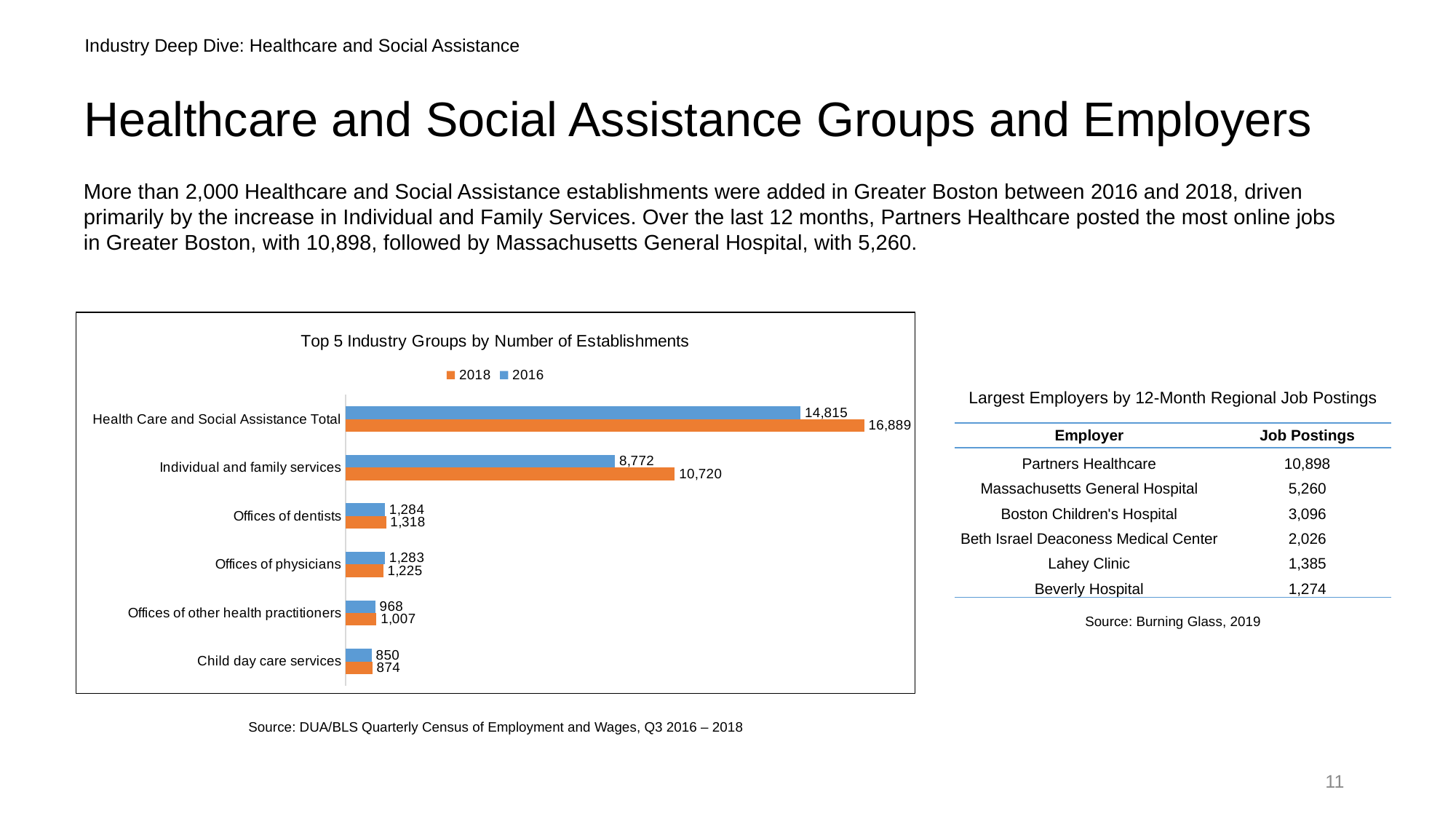
How many series does the chart legend list? 2 What type of chart is used to show the Top 5 Industry Groups by Number of Establishments? Bar chart What was the Health Care and Social Assistance Total in 2016? 14,815 For Offices of physicians, which year had more establishments, 2016 or 2018? 2016 What was the number of establishments for Individual and family services in 2018? 10,720 Excluding the total, which industry group had the most establishments in 2018? Individual and family services How many categories are shown on the chart? 6 What was the number of establishments for Offices of dentists in 2016? 1,284 What was the number of establishments for Child day care services in 2018? 874 By how much did the Health Care and Social Assistance Total increase from 2016 to 2018? 2,074 Which industry group had the fewest establishments in 2016? Child day care services What is the difference between the 2018 and 2016 values for Individual and family services? 1,948